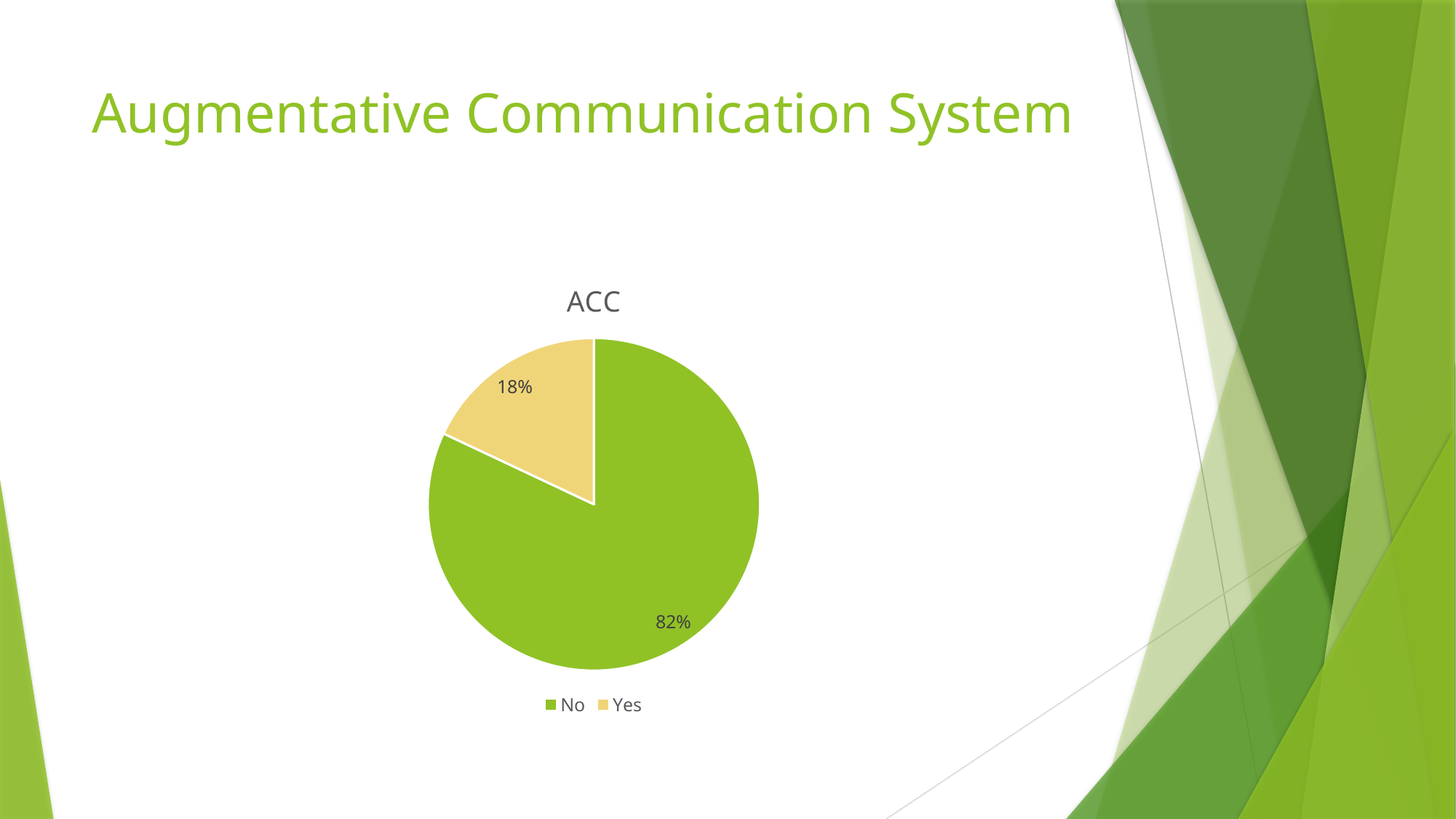
What share of the pie does the "No" slice represent? 82% Which slice is the largest in the pie chart? No What is the difference in percentage points between the "No" and "Yes" slices? 64 Which is larger, the "Yes" slice or the "No" slice? No What is the title of the chart? ACC What percentage of the pie is the "Yes" slice? 18% What percentage of the pie is the "No" slice? 82% What kind of chart is shown on the slide? pie chart How many entries does the legend list? 2 What colour is the "Yes" slice? yellow How many slices does the pie chart have? 2 Which slice is the smallest in the pie chart? Yes